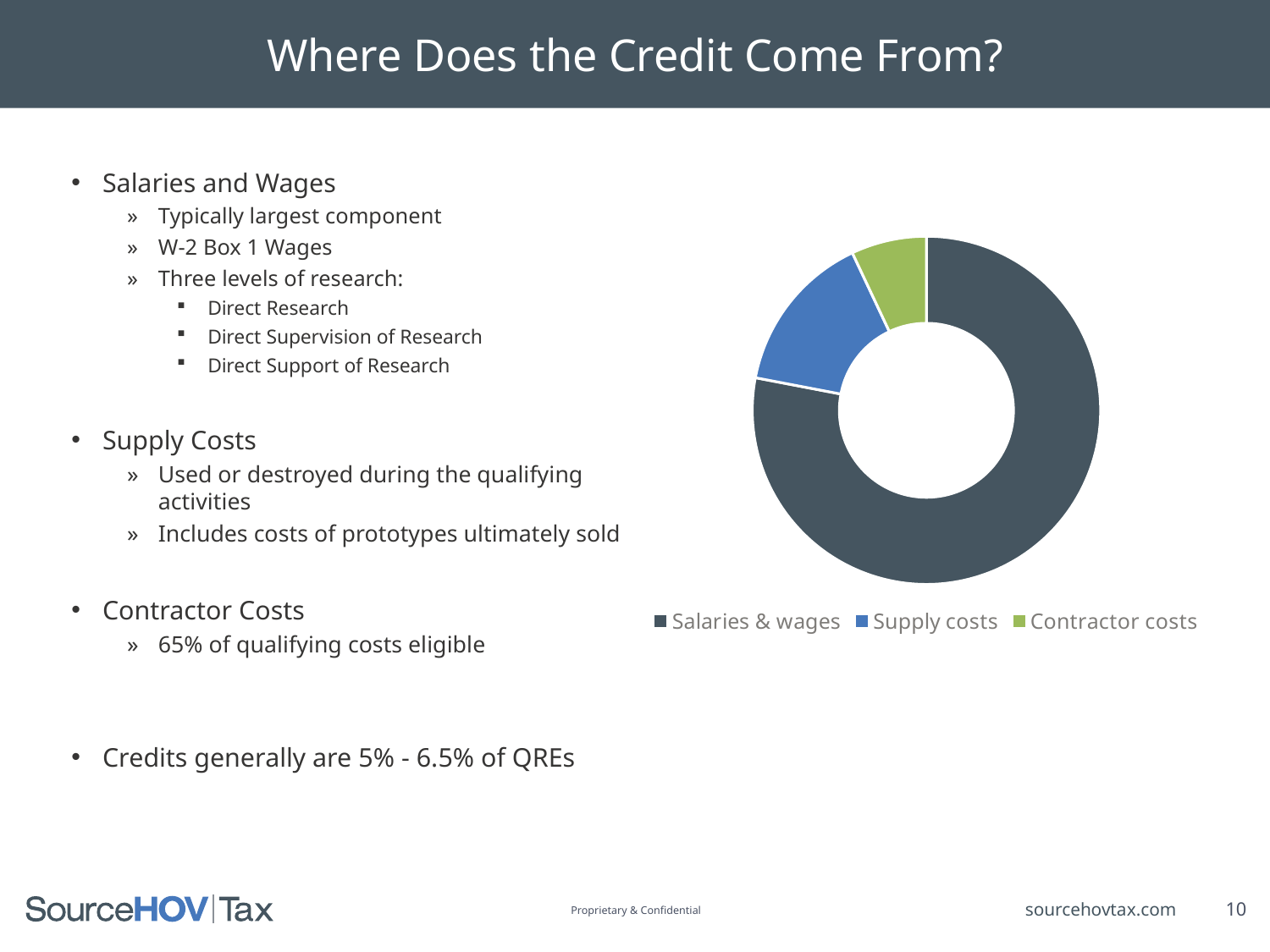
What colour is the Contractor costs slice in the chart? Green Which is larger in the chart, Salaries & wages or Supply costs? Salaries & wages Which category takes up the smallest share of the doughnut chart? Contractor costs How many categories does the doughnut chart show? 3 Which category takes up the largest share of the doughnut chart? Salaries & wages Does the Salaries & wages slice make up more or less than half of the doughnut chart? More Which is larger in the chart, Supply costs or Contractor costs? Supply costs Where is the legend positioned relative to the doughnut chart? Below the chart How many entries does the chart legend list? 3 What kind of chart is shown on the slide? Doughnut chart